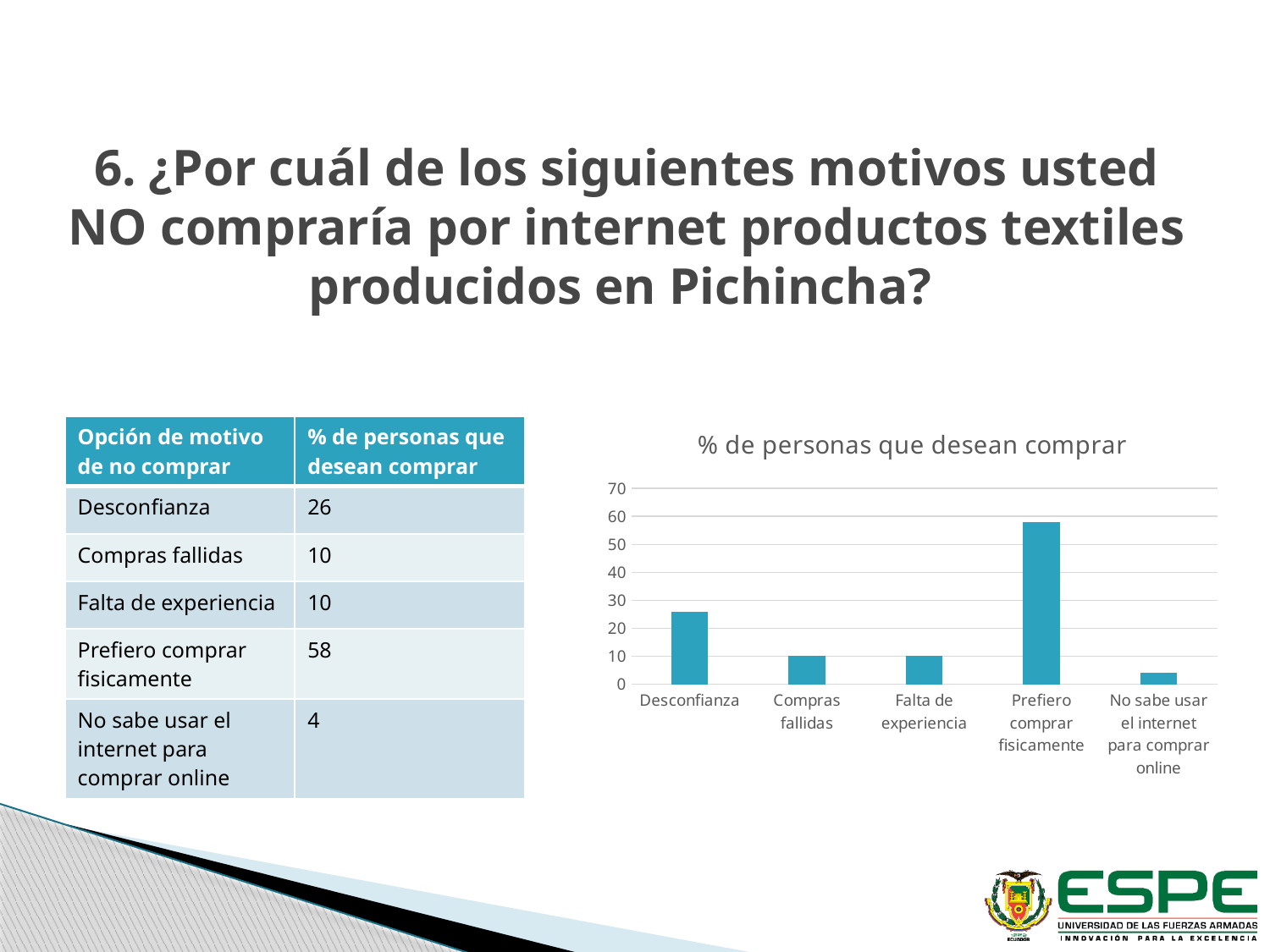
What is the value for Desconfianza? 26 What type of chart is shown on the slide? bar chart Which category has the lowest value in the chart? No sabe usar el internet para comprar online Which category has the highest value in the chart? Prefiero comprar fisicamente How many categories are plotted in the chart? 5 What is the value for No sabe usar el internet para comprar online? 4 Which is larger, the value for Desconfianza or the value for Compras fallidas? Desconfianza Is the value for Falta de experiencia greater or less than 20? less What is the title of the chart? % de personas que desean comprar What is the value for Prefiero comprar fisicamente? 58 Is the value for Prefiero comprar fisicamente greater or less than 50? greater What is the difference between the values for Prefiero comprar fisicamente and Desconfianza? 32